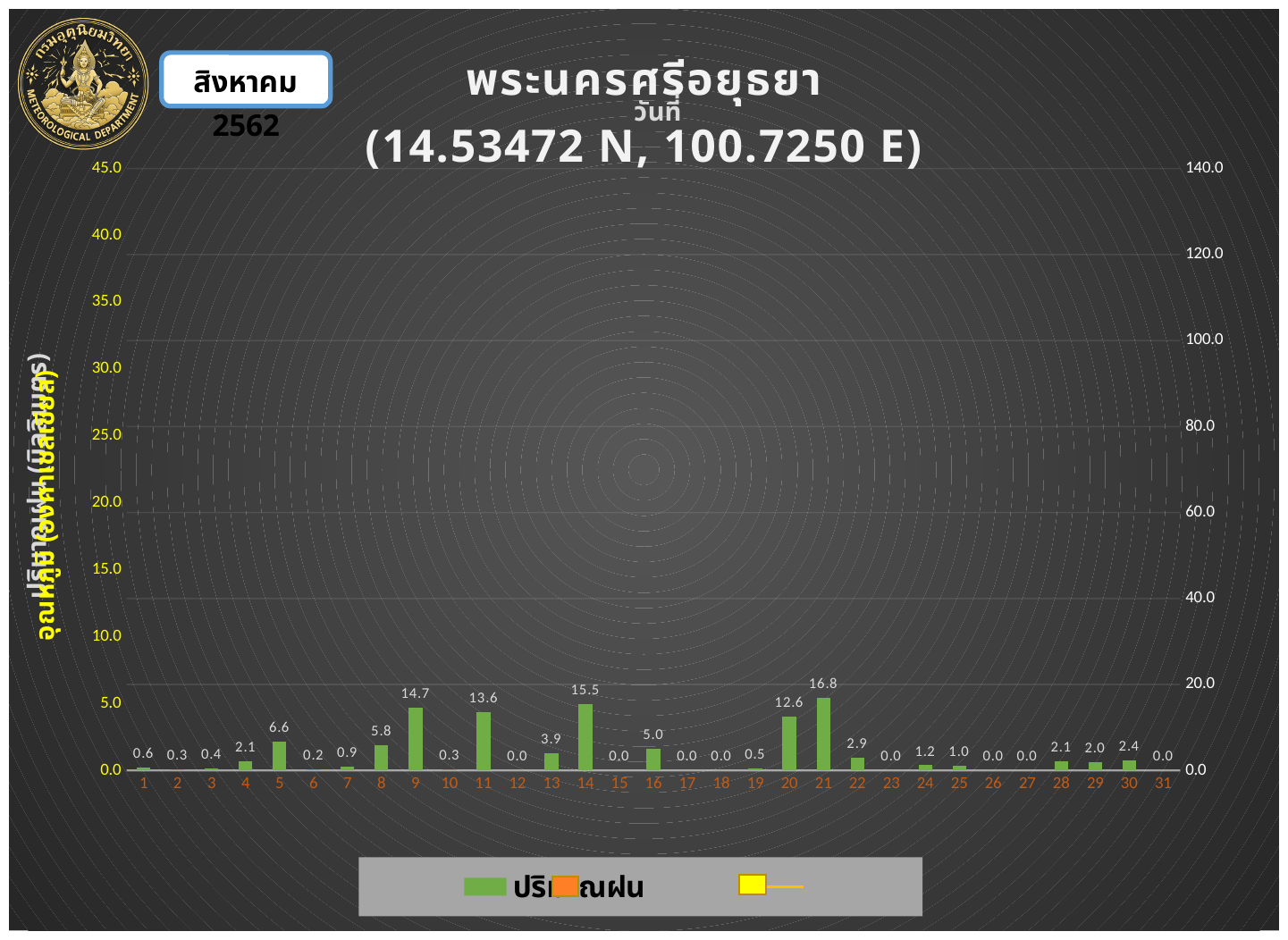
What is the rainfall value for day 30? 2.4 How many days (categories) are shown on the x axis? 31 Which day has the highest rainfall value? 21 Which has a larger rainfall value, day 20 or day 8? day 20 What is the difference between the rainfall values for day 21 and day 14? 1.3 What is the rainfall value (ปริมาณฝน) for day 21? 16.8 What is the difference between the rainfall values for day 9 and day 11? 1.1 What kind of chart is used to show the rainfall values? bar chart What is the rainfall value for day 9? 14.7 What is the rainfall value for day 5? 6.6 What station name is shown in the chart title? พระนครศรีอยุธยา Which has a larger rainfall value, day 16 or day 13? day 16